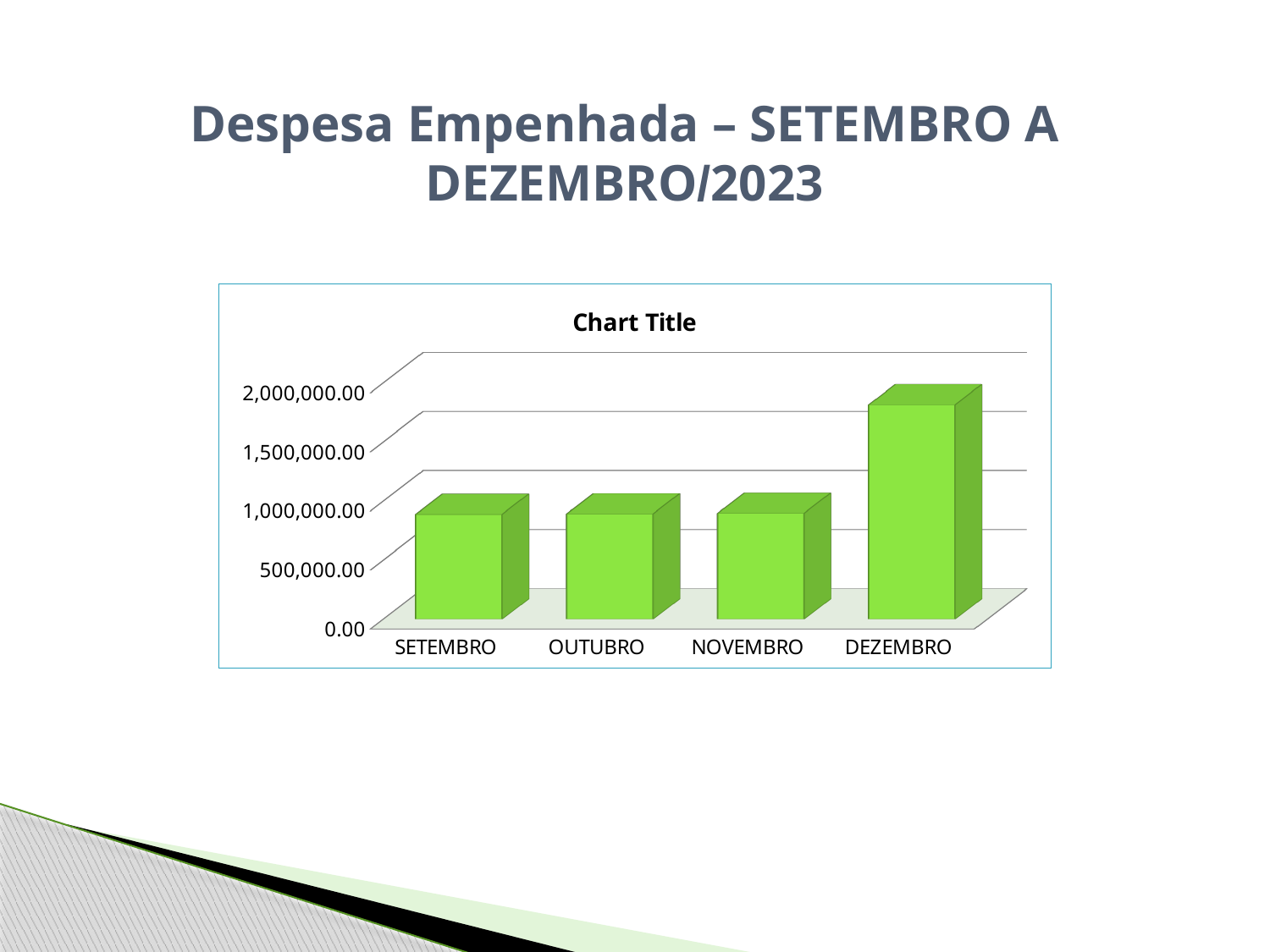
Is the value for OUTUBRO greater or less than 500,000.00? greater What kind of chart is shown on the slide? bar chart What is the highest value labelled on the chart's vertical axis? 2,000,000.00 Is the value for NOVEMBRO greater or less than 1,500,000.00? less What is the title printed above the chart's plot area? Chart Title Which month is listed first on the x axis of the chart? SETEMBRO Which month has the highest bar in the chart? DEZEMBRO Is the value for DEZEMBRO greater or less than 1,500,000.00? greater How many months are shown on the x axis of the chart? 4 Which is larger, the value for OUTUBRO or the value for DEZEMBRO? DEZEMBRO Which is larger, the value for DEZEMBRO or the value for SETEMBRO? DEZEMBRO